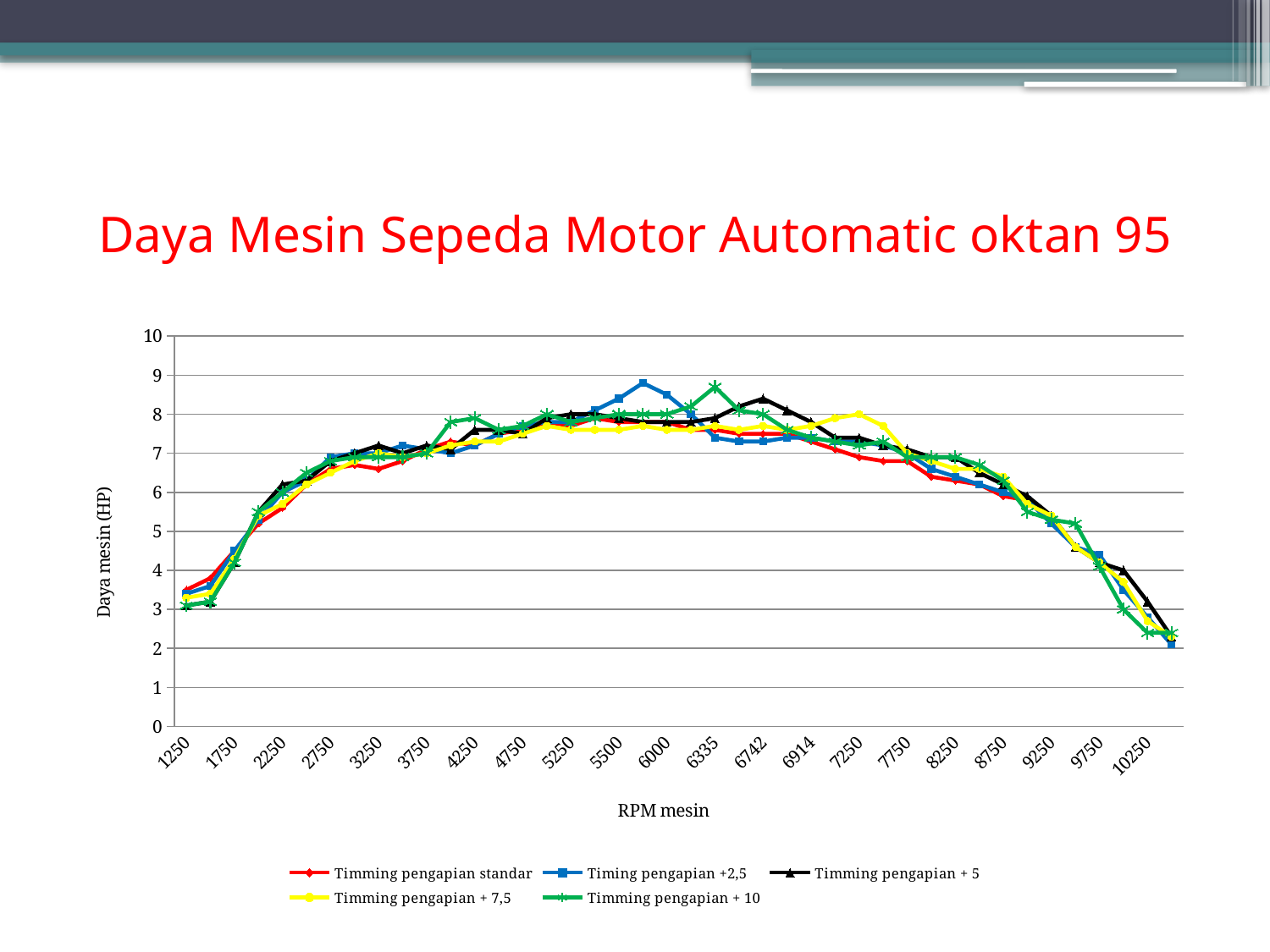
Which series has the highest value at 6335 RPM? Timming pengapian + 10 How many series does the legend list? 5 What kind of chart is shown on the slide? line chart Is the value for Timing pengapian +2,5 at 10250 RPM greater or less than 3? less Is the value for Timing pengapian +2,5 at 6000 RPM greater or less than 8? greater Is the value for Timming pengapian + 7,5 at 7250 RPM greater or less than 7? greater From 8750 RPM to 10250 RPM, do the values for Timming pengapian + 5 rise or fall? fall Which series has the highest value at 6000 RPM? Timing pengapian +2,5 What is the title of the chart? Daya Mesin Sepeda Motor Automatic oktan 95 What is the label of the vertical axis? Daya mesin (HP)